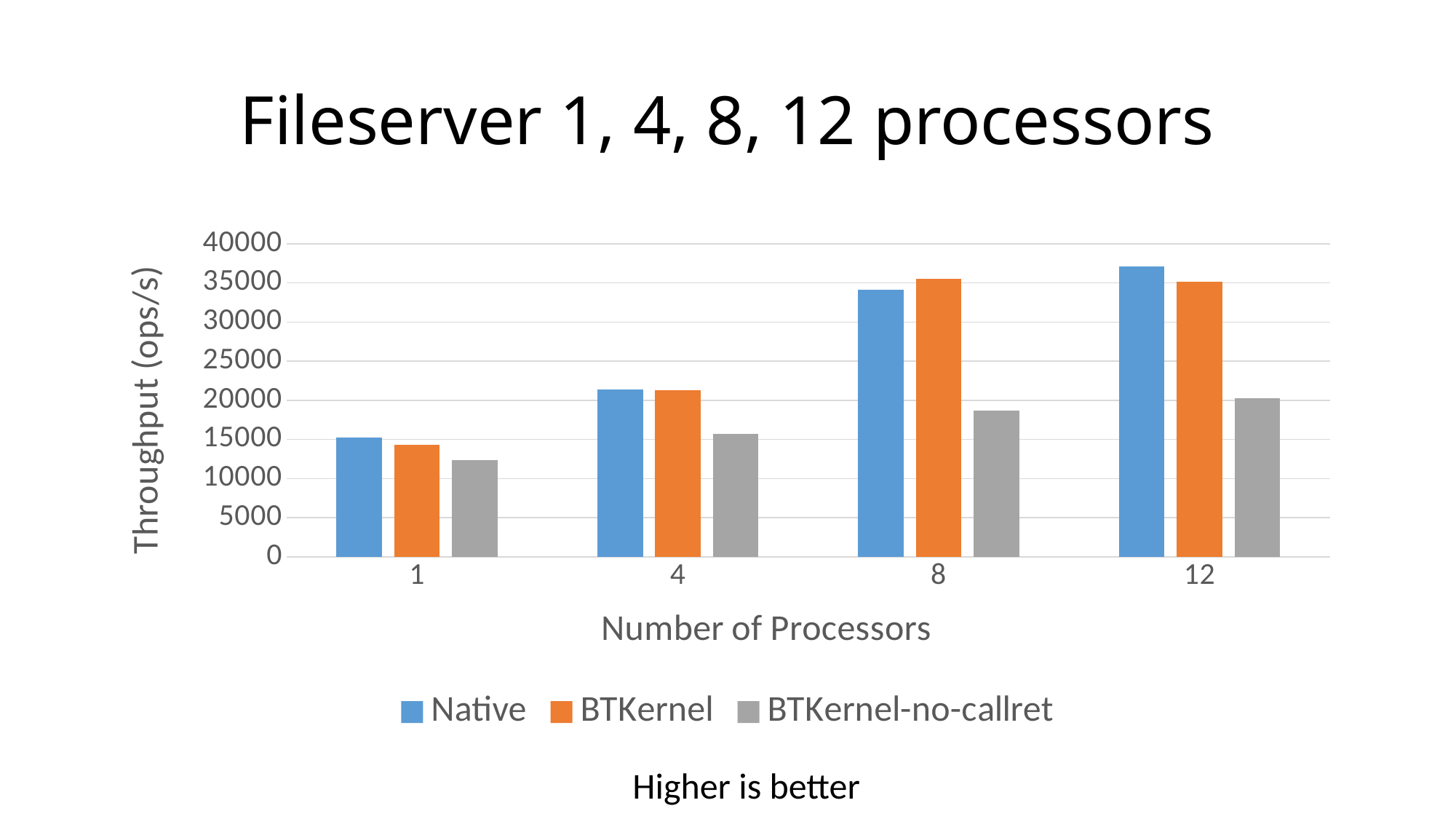
How many processor counts are shown on the x axis? 4 Is the BTKernel throughput at 1 processor greater or less than 15000? less What kind of chart is shown on the slide? bar chart Is the Native throughput at 12 processors greater or less than 35000? greater At 8 processors, which is higher: Native or BTKernel? BTKernel Is the BTKernel throughput at 8 processors greater or less than 30000? greater Does the Native throughput rise or fall as the number of processors increases? rise Which series has the lowest throughput at 1 processor? BTKernel-no-callret How many series does the legend list? 3 What is the label of the y axis? Throughput (ops/s)